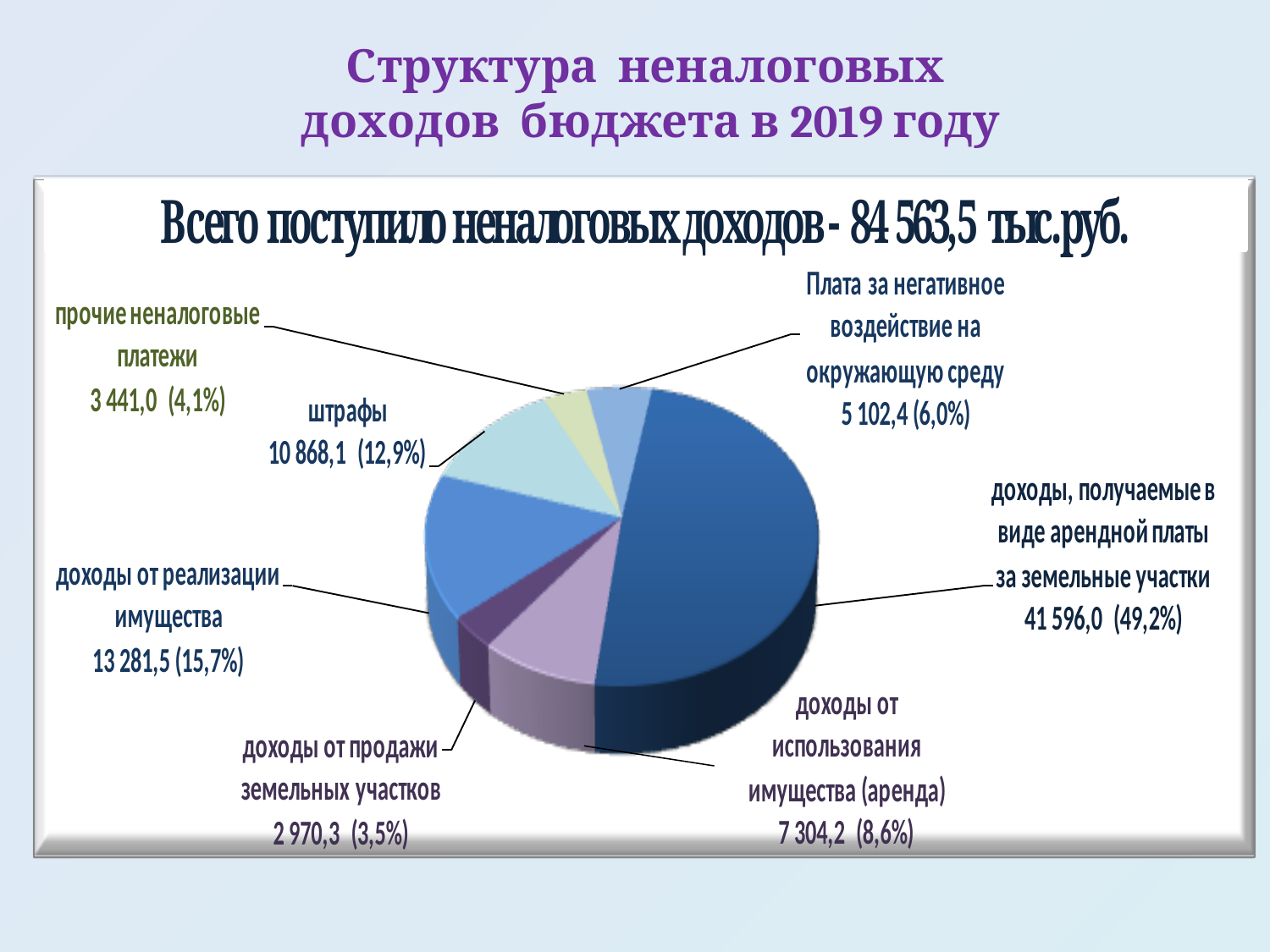
What share of the pie is "доходы от реализации имущества"? 15,7% What kind of chart is shown on the slide? pie chart What is the value for "Плата за негативное воздействие на окружающую среду"? 5 102,4 What is the value for "доходы от использования имущества (аренда)"? 7 304,2 Which category has the largest slice of the pie? доходы, получаемые в виде арендной платы за земельные участки What total amount of non-tax revenue is stated in the chart title? 84 563,5 тыс.руб. How many slices does the pie chart have? 7 What is the value for "штрафы"? 10 868,1 What is the difference in percentage points between "доходы от реализации имущества" (15,7%) and "штрафы" (12,9%)? 2,8 Which is larger: "штрафы" or "доходы от использования имущества (аренда)"? штрафы Which category has the smallest slice of the pie? доходы от продажи земельных участков What share of the pie is "прочие неналоговые платежи"? 4,1%